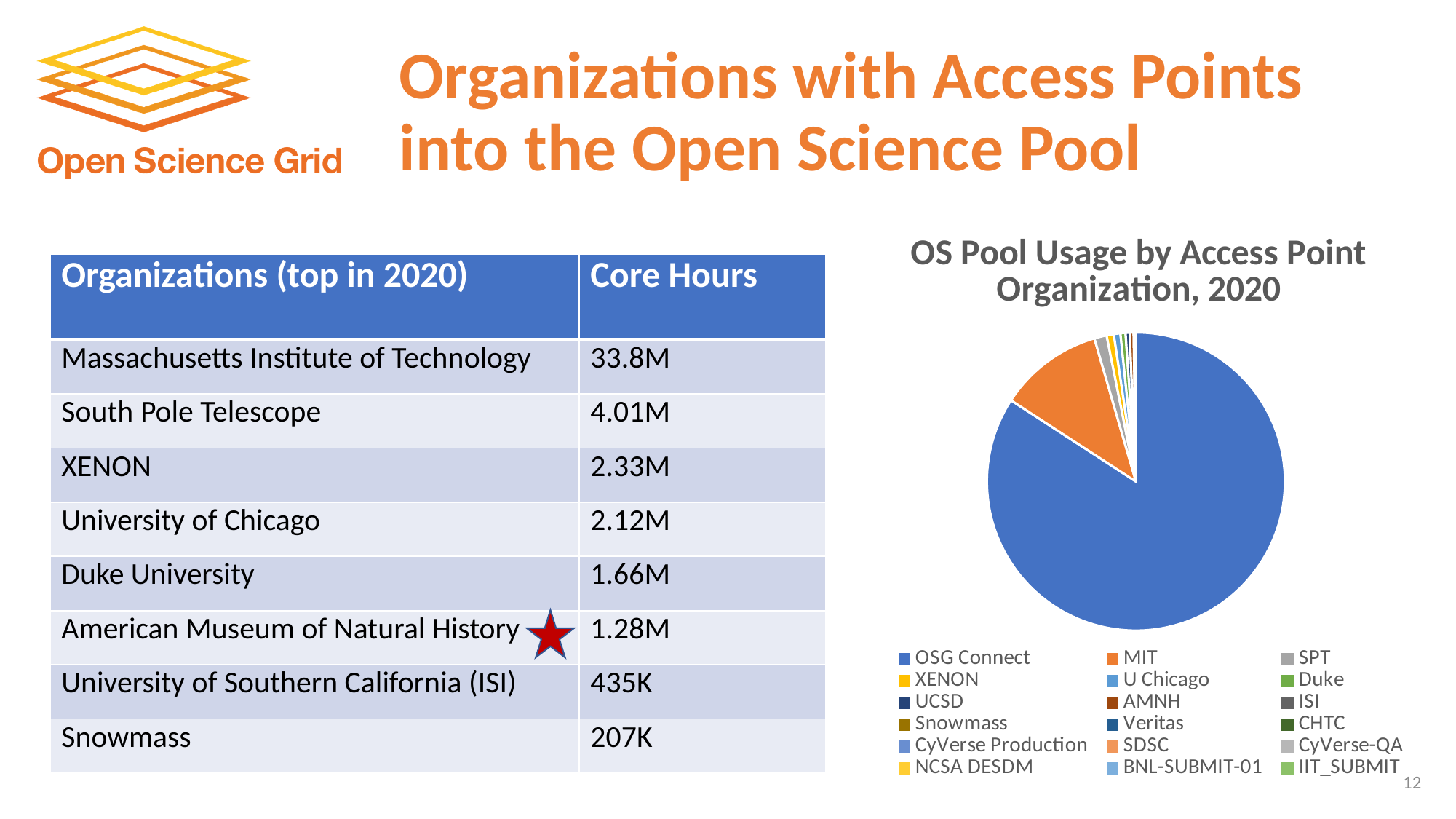
What colour is the OSG Connect slice in the pie chart? blue In the pie chart, which slice is larger: OSG Connect or MIT? OSG Connect In the pie chart, which slice is larger: MIT or SPT? MIT Which organization has the largest slice in the pie chart? OSG Connect Does the OSG Connect slice take up more or less than half of the pie chart? more What is the title of the pie chart? OS Pool Usage by Access Point Organization, 2020 What kind of chart is shown on the right side of the slide? pie chart Does the MIT slice take up more or less than half of the pie chart? less Which organization has the second-largest slice in the pie chart? MIT How many organizations are listed in the pie chart's legend? 18